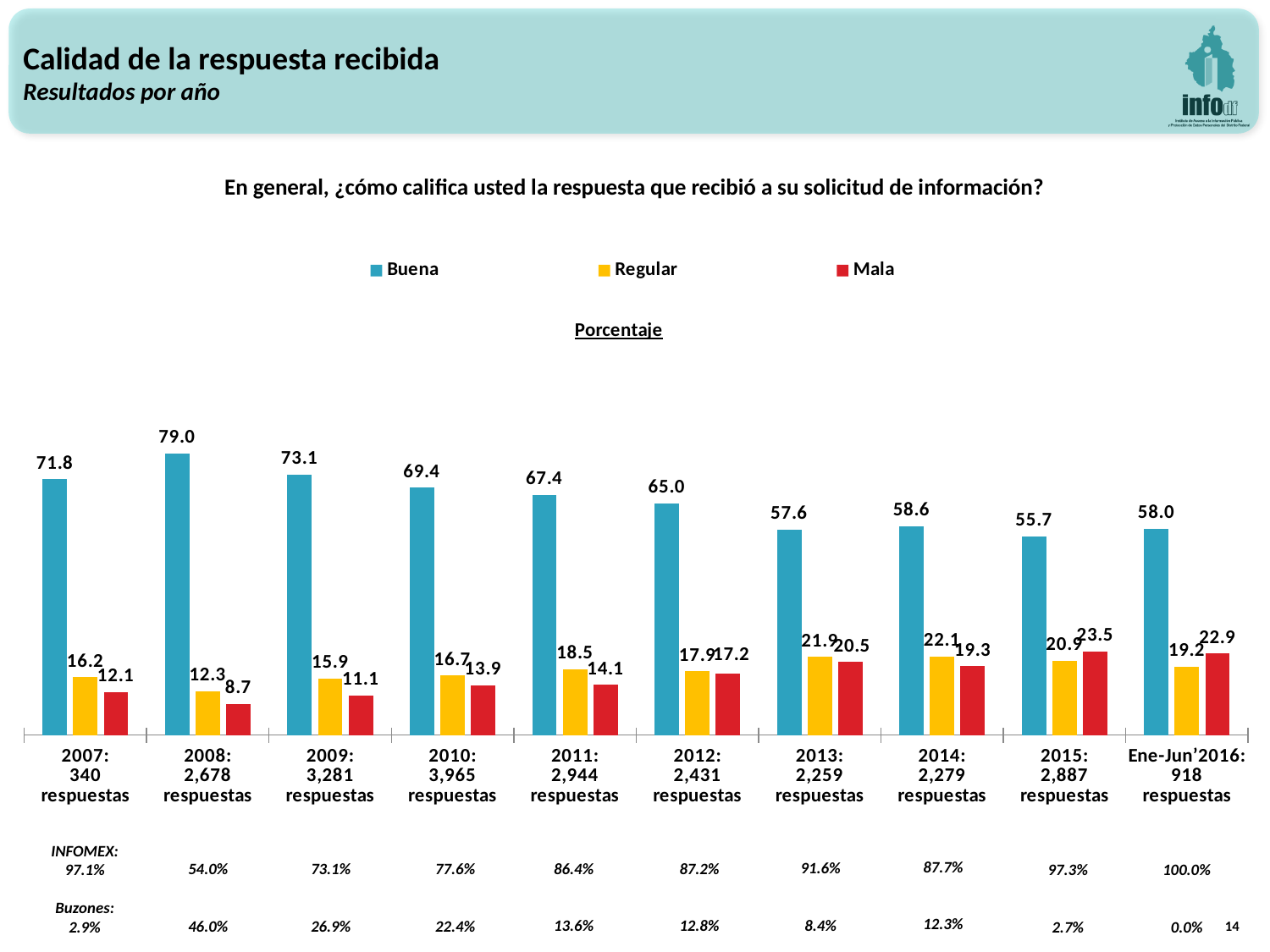
How many year categories are shown on the x axis? 10 What is the value for Regular in 2014? 22.1 Which is larger in 2013, Regular or Mala? Regular What is the value for Mala in 2015? 23.5 How many series does the legend list? 3 Does the Mala series generally rise or fall from 2008 to 2015? rise Which colour represents the Regular series? yellow What is the difference between the Buena values for 2007 and 2015? 16.1 What is the value for Buena in 2008? 79.0 What kind of chart is shown? bar chart In which year is the Mala value lowest? 2008 In which year is the Buena value highest? 2008